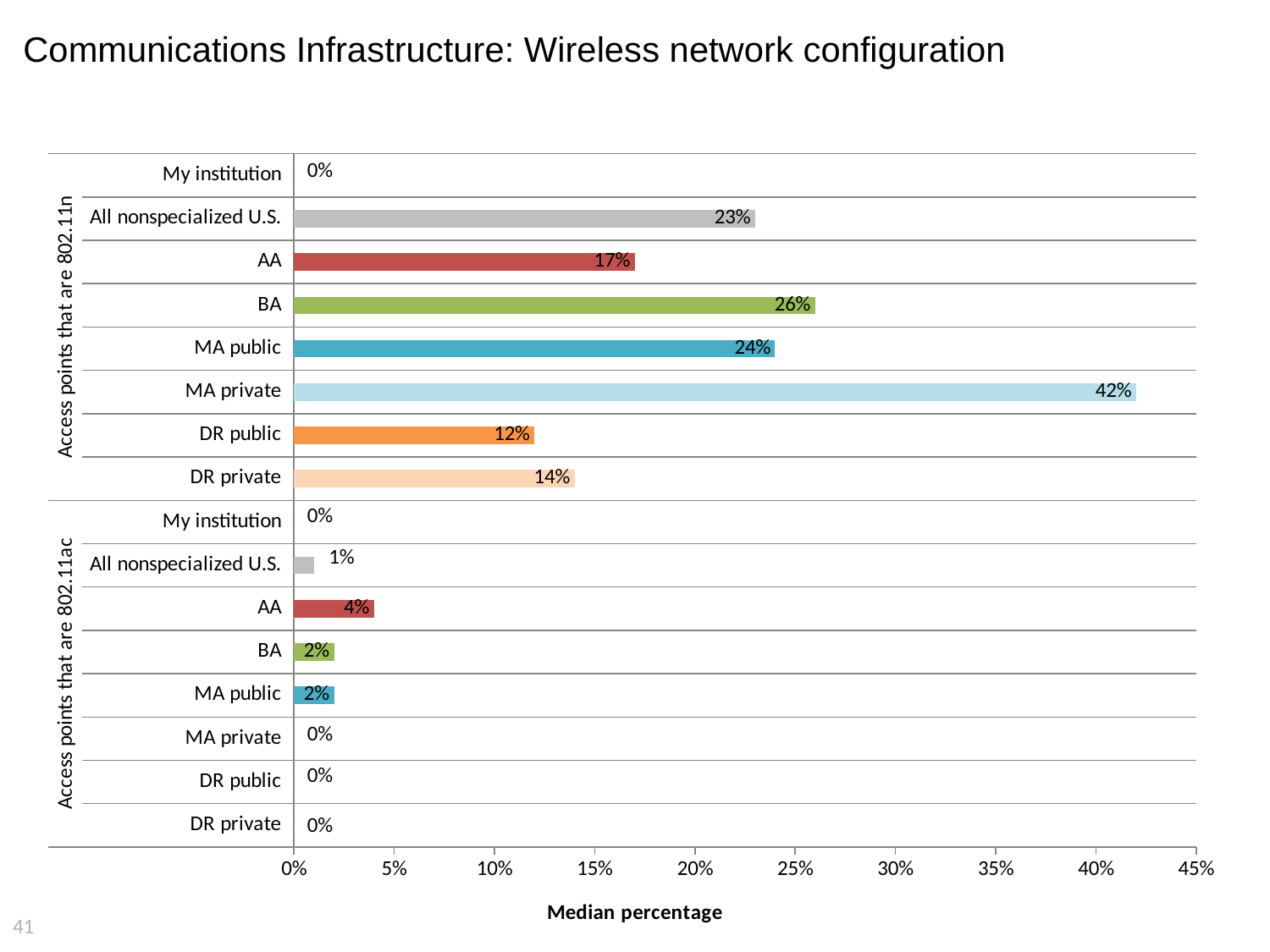
What is the median percentage of access points that are 802.11n for All nonspecialized U.S.? 23% What is the median percentage of access points that are 802.11n for MA private? 42% For access points that are 802.11n, which is larger: DR private or DR public? DR private What is the difference between the 802.11n median percentages for BA and AA? 9% Among the categories with a non-zero bar, which has the lowest median percentage of access points that are 802.11n? DR public Which category has the highest median percentage of access points that are 802.11ac? AA What is the difference between the 802.11n median percentages for MA private and MA public? 18% Which category has the highest median percentage of access points that are 802.11n? MA private What is the median percentage of access points that are 802.11ac for AA? 4% What is the label of the horizontal axis? Median percentage What kind of chart is shown on the slide? Bar chart How many categories are listed in the 802.11ac group? 8